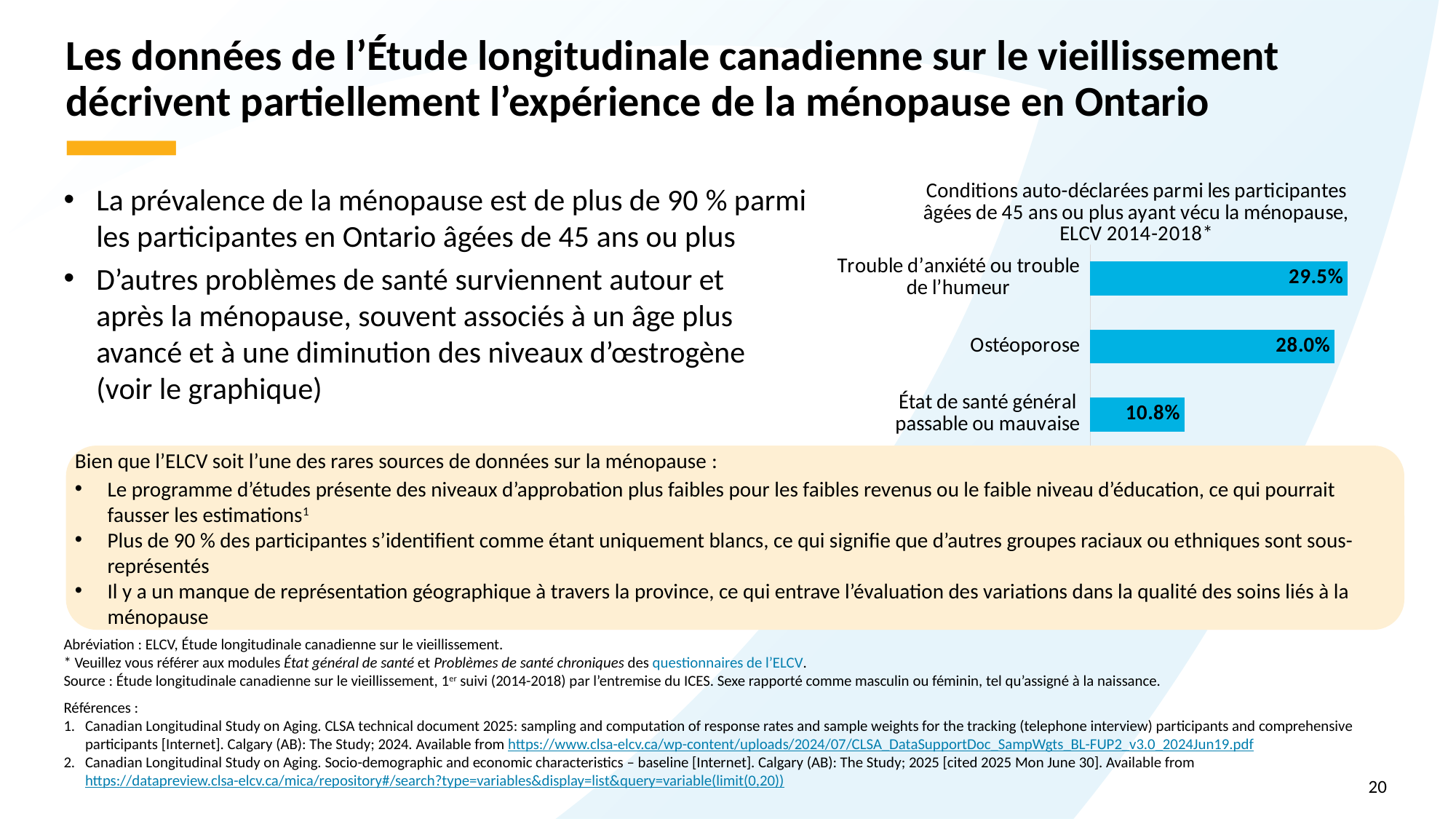
What is the difference between the values for "Trouble d'anxiété ou trouble de l'humeur" and "Ostéoporose"? 1.5% Which is larger: the value for "Ostéoporose" or the value for "État de santé général passable ou mauvaise"? Ostéoporose What is the value for "État de santé général passable ou mauvaise"? 10.8% Which condition has the lowest value in the chart? État de santé général passable ou mauvaise What colour are the bars in the chart? Blue What kind of chart is shown on the slide? Bar chart What is the value for "Ostéoporose"? 28.0% What is the title of the chart? Conditions auto-déclarées parmi les participantes âgées de 45 ans ou plus ayant vécu la ménopause, ELCV 2014-2018* How many conditions are shown in the chart? 3 Which condition has the highest value in the chart? Trouble d'anxiété ou trouble de l'humeur What is the value for "Trouble d'anxiété ou trouble de l'humeur"? 29.5% What is the difference between the values for "Ostéoporose" and "État de santé général passable ou mauvaise"? 17.2%